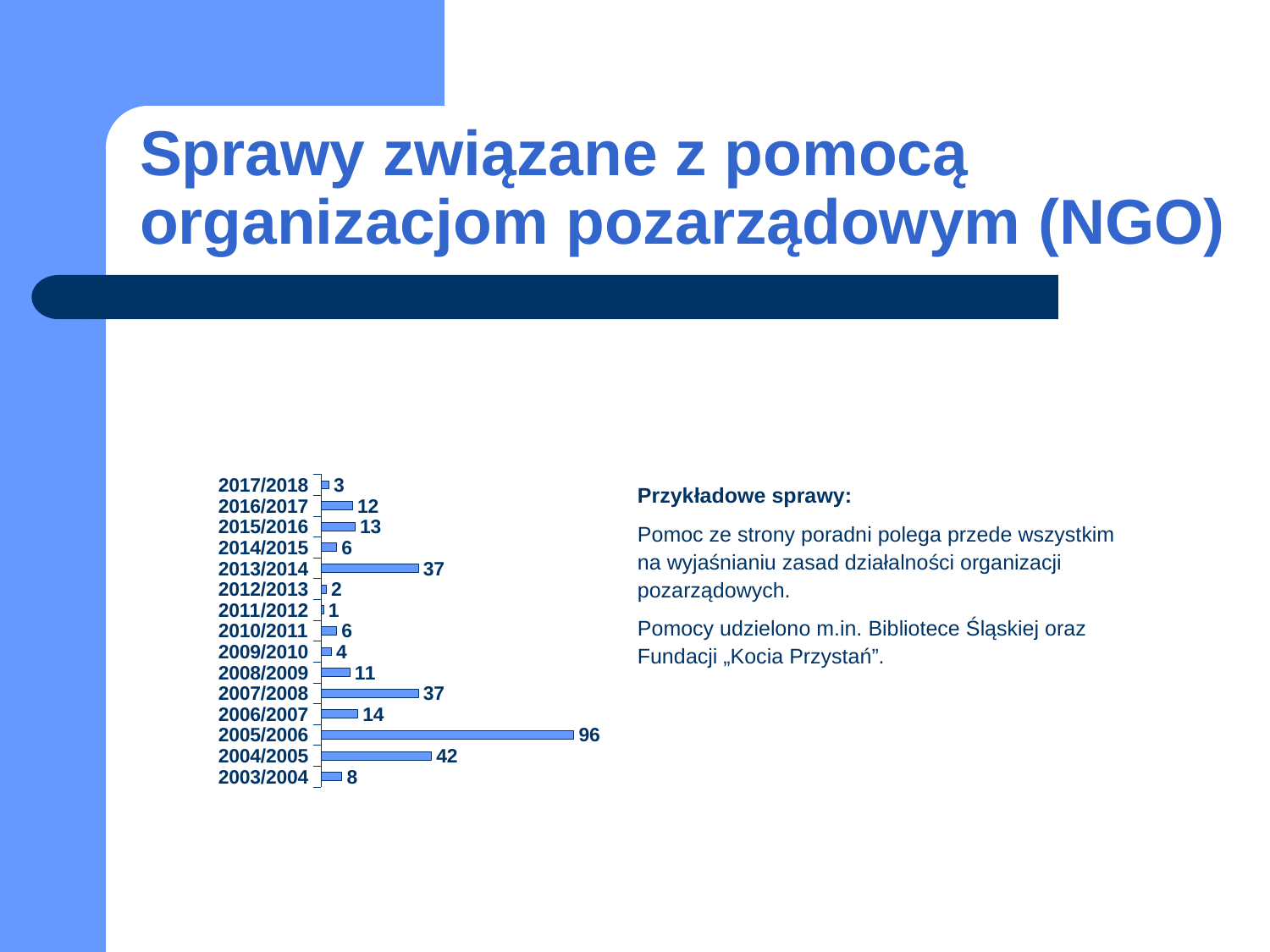
What is the value for 2003/2004? 8 What is the difference between the values for 2015/2016 and 2014/2015? 7 What kind of chart is shown on the slide? bar chart Which is larger, the value for 2016/2017 or the value for 2006/2007? 2006/2007 Which year has the highest value? 2005/2006 What is the value for 2013/2014? 37 What is the difference between the values for 2005/2006 and 2004/2005? 54 Which year has the lowest value? 2011/2012 What is the value for 2008/2009? 11 Which is larger, the value for 2017/2018 or the value for 2009/2010? 2009/2010 How many years (categories) are shown in the chart? 15 What is the value for 2005/2006? 96